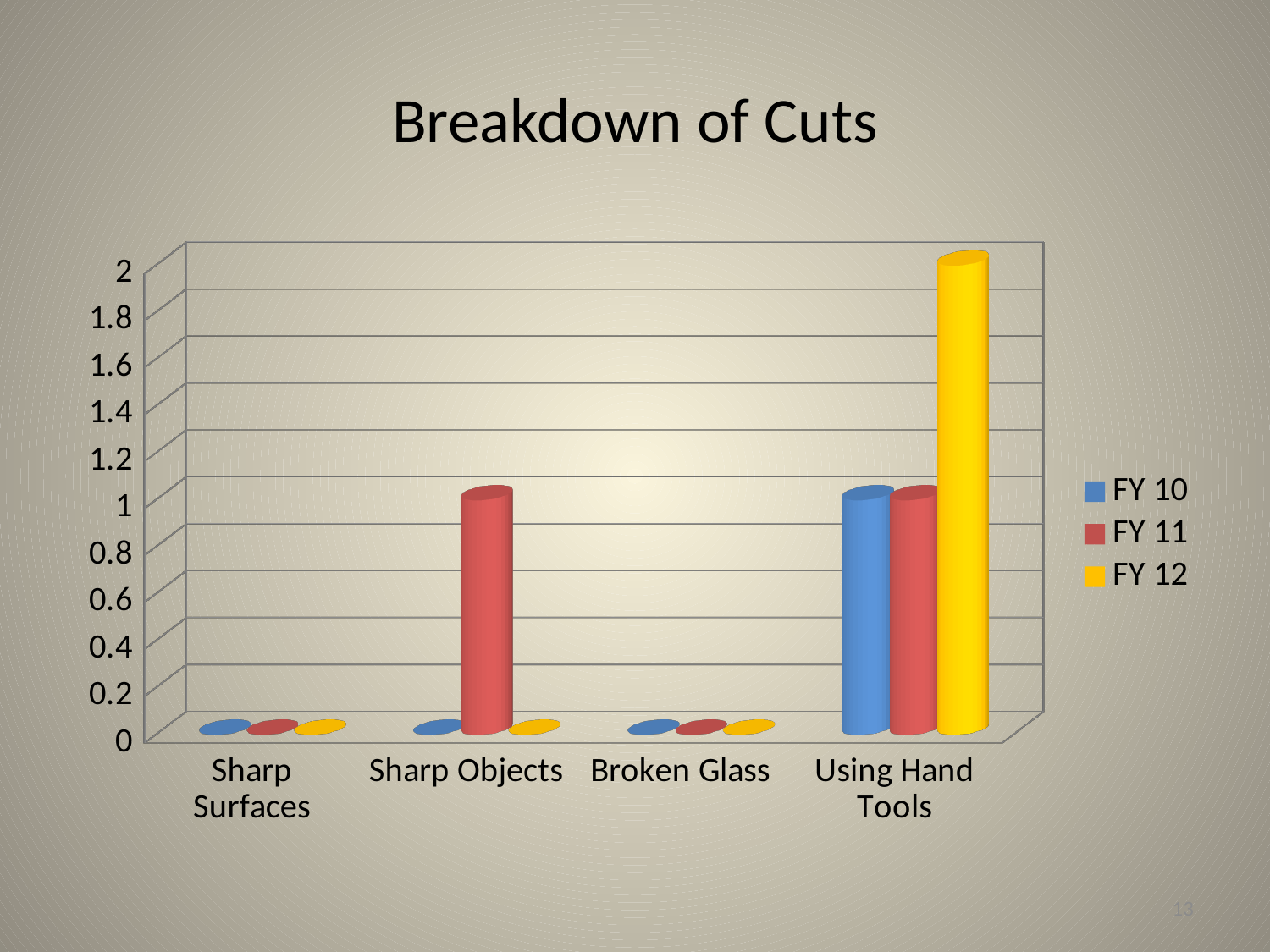
What kind of chart is shown on the slide? Bar chart How many series does the legend list? 3 What is the FY 11 value for Sharp Objects? 1 Which series is shown in yellow in the legend? FY 12 What is the FY 10 value for Broken Glass? 0 What is the title of the chart? Breakdown of Cuts What is the FY 10 value for Using Hand Tools? 1 Which category has the highest FY 12 value? Using Hand Tools What is the difference between the FY 12 and FY 11 values for Using Hand Tools? 1 What is the FY 12 value for Using Hand Tools? 2 Which is larger: the FY 11 value for Sharp Objects or the FY 12 value for Using Hand Tools? FY 12 value for Using Hand Tools How many categories are shown on the x axis? 4